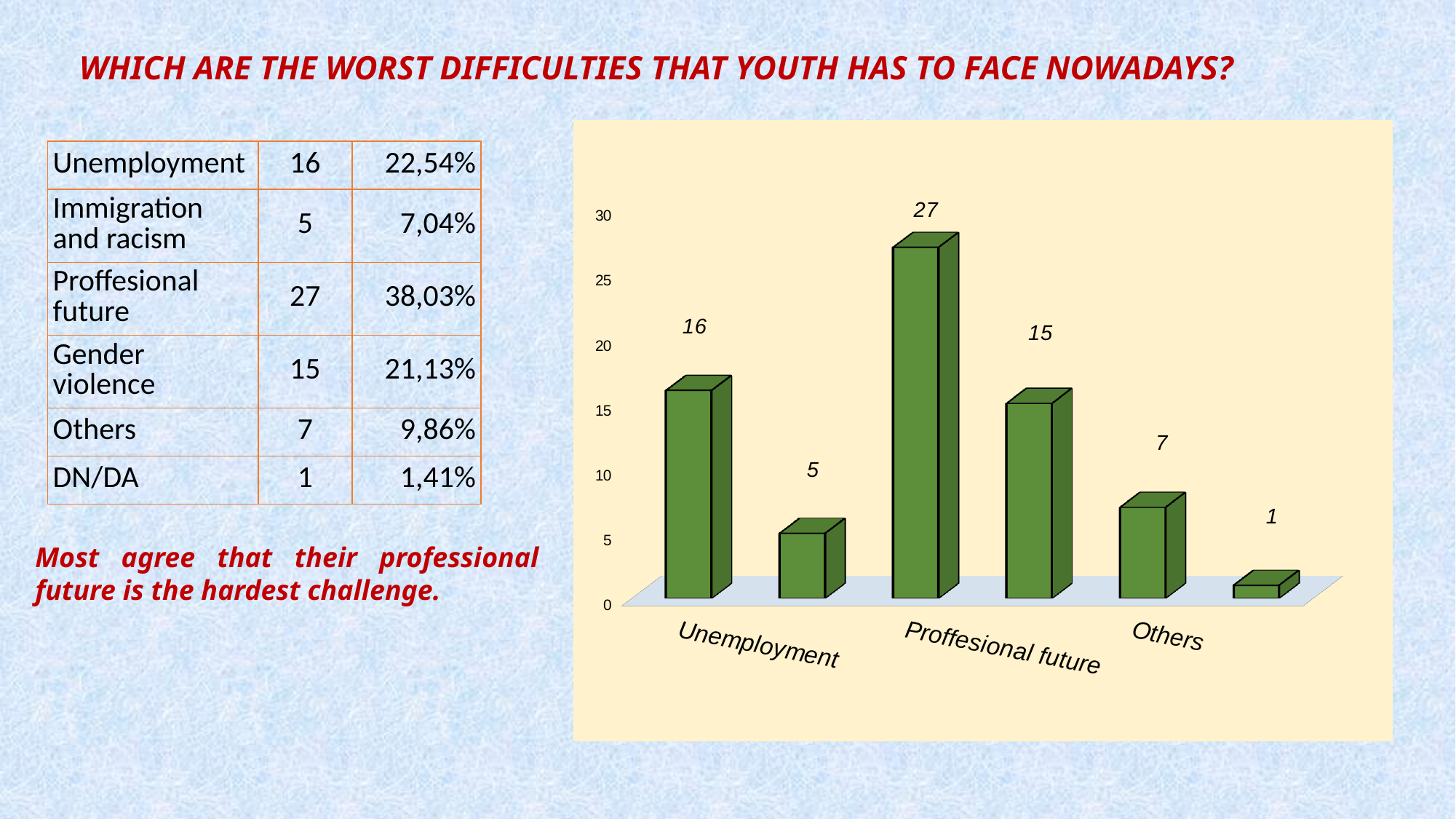
What kind of chart is shown on the slide? bar chart What is the difference between the Proffesional future bar and the Unemployment bar? 11 What is the value of the Unemployment bar? 16 Is the value for Proffesional future greater or less than 25? greater Which is larger, the Unemployment bar or the Others bar? Unemployment What is the value of the second bar from the left? 5 What is the value of the fourth bar from the left? 15 How many bars are in the chart? 6 What is the value of the lowest bar in the chart? 1 What is the value of the Proffesional future bar? 27 Which category has the highest bar? Proffesional future What is the value of the Others bar? 7